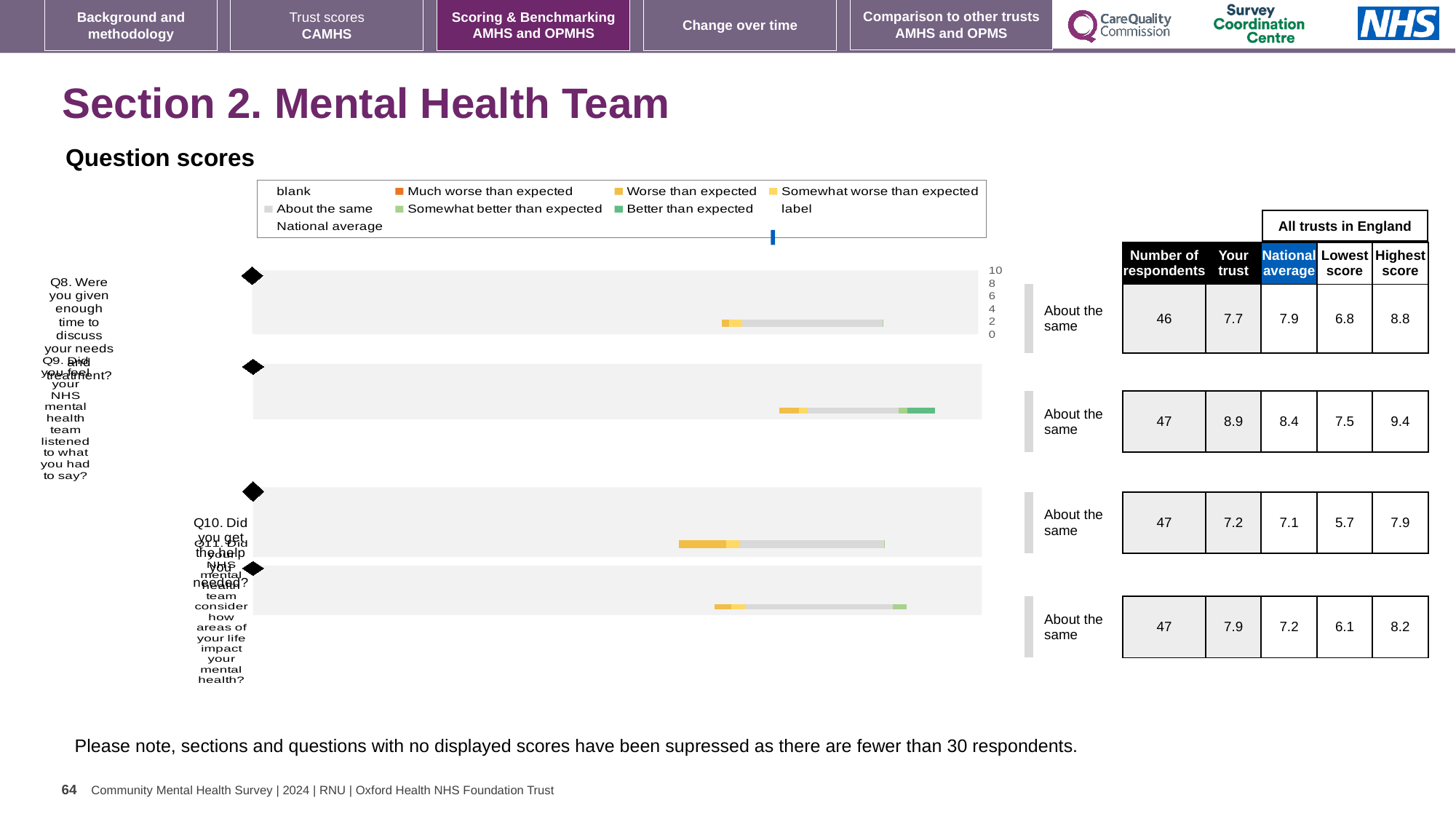
How many questions (Q8 to Q11) are plotted in the question scores chart? 4 What is the difference between the 'Your trust' score and the national average for Q9? 0.5 For Q8, which is larger: the 'Your trust' score or the national average? National average Which question has the highest 'Your trust' score in the table beside the chart? Q9 What benchmark label is shown to the right of each bar in the question scores chart? About the same In the chart legend, what colour represents 'Better than expected'? green How many respondents answered Q8 according to the table beside the chart? 46 Which question has the lowest 'Your trust' score in the table beside the chart? Q10 What is the highest score among all trusts in England for Q9? 9.4 According to the table next to the chart, what is the national average for Q11 (Did your NHS mental health team consider how areas of your life impact your mental health)? 7.2 According to the table next to the chart, what is the 'Your trust' score for Q9 (Did you feel your NHS mental health team listened to what you had to say)? 8.9 What kind of chart is used to show the question scores on this slide? bar chart